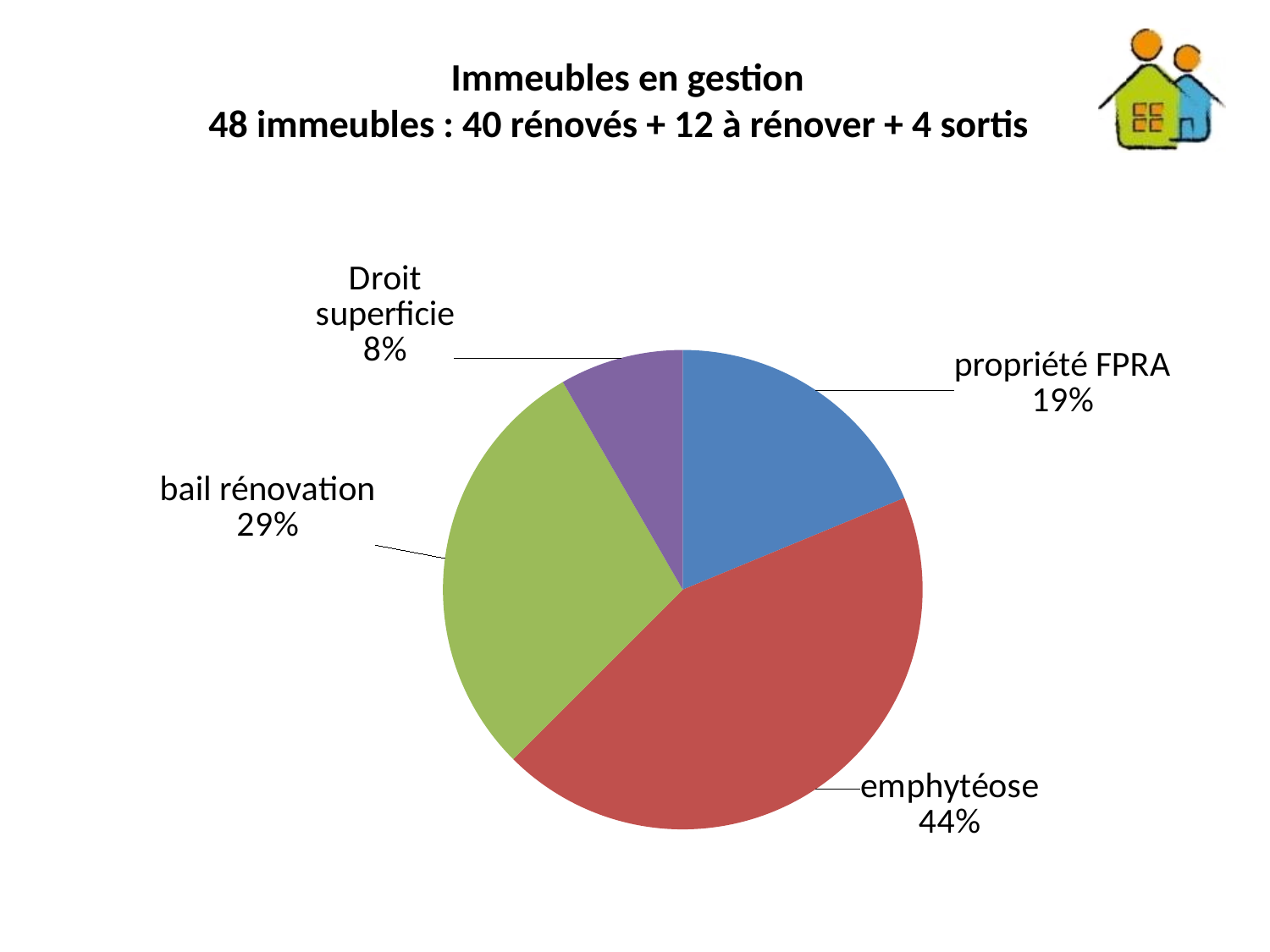
What kind of chart is shown on the slide? pie chart How many slices does the pie chart have? 4 What share of the pie does Droit superficie represent? 8% What share of the pie does propriété FPRA represent? 19% What share of the pie does bail rénovation represent? 29% Which is larger, the share for bail rénovation or the share for propriété FPRA? bail rénovation Which category has the largest slice of the pie? emphytéose Which category has the smallest slice of the pie? Droit superficie What is the difference in percentage points between the propriété FPRA share and the Droit superficie share? 11 What is the difference in percentage points between the emphytéose share and the bail rénovation share? 15 What colour is the emphytéose slice? red